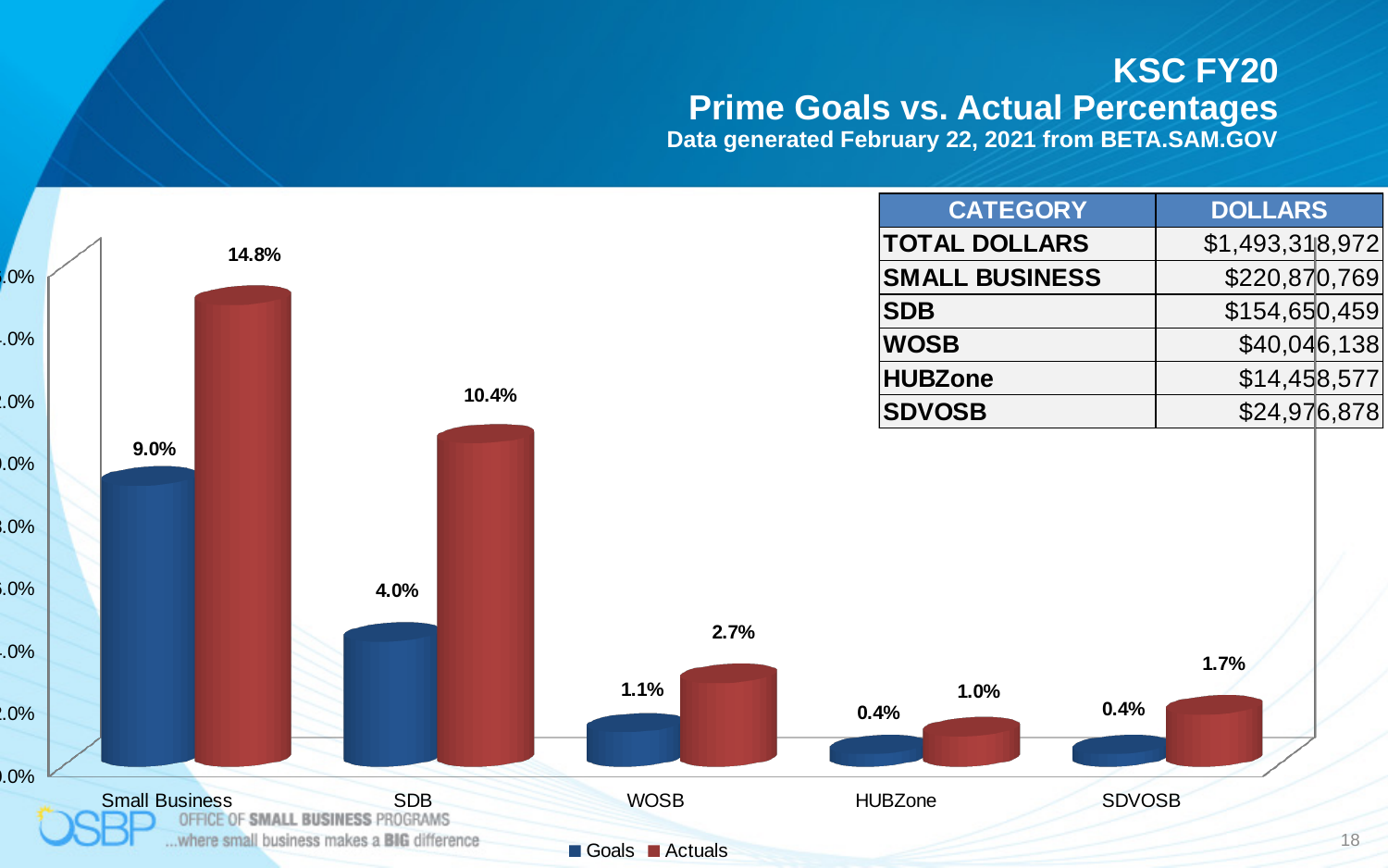
Which is larger for SDVOSB, the Goals value or the Actuals value? Actuals How many series does the chart legend list? 2 What is the difference between the Actuals and Goals values for SDB? 6.4% What is the Goals value for SDB? 4.0% What is the Actuals value for WOSB? 2.7% What is the Actuals value for Small Business? 14.8% Which category has the highest Actuals value? Small Business Which category has the lowest Actuals value? HUBZone Which series is shown in red in the chart? Actuals What kind of chart is shown on the slide? Bar chart What is the Goals value for HUBZone? 0.4% How many categories are shown on the x axis of the chart? 5